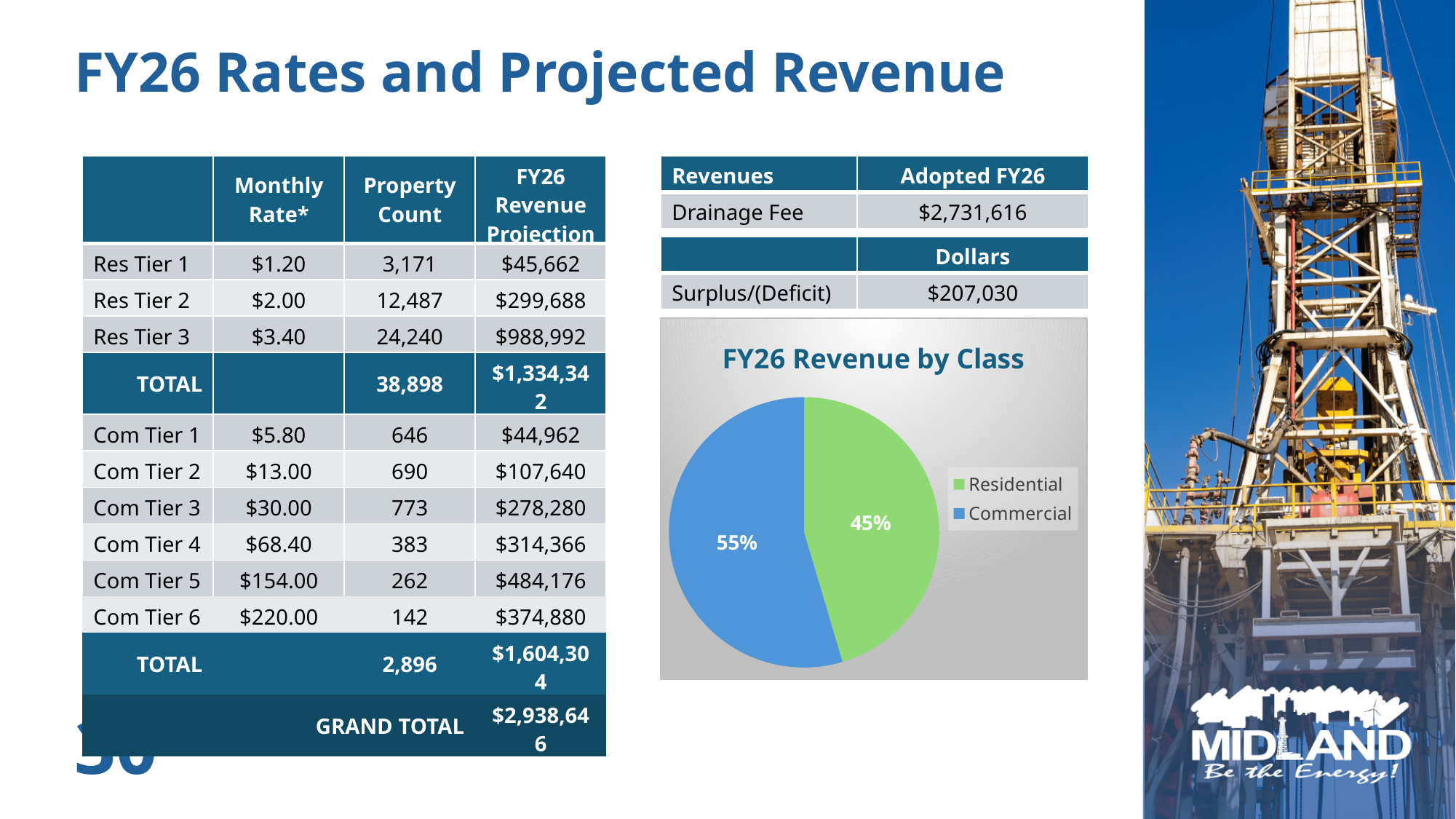
What kind of chart is FY26 Revenue by Class? Pie chart In the FY26 Revenue by Class chart, by how many percentage points does Commercial exceed Residential? 10 percentage points How many entries does the legend of the FY26 Revenue by Class chart list? 2 What share of the FY26 Revenue by Class pie chart is Commercial? 55% In the FY26 Revenue by Class chart, which is larger, Residential or Commercial? Commercial How many slices does the FY26 Revenue by Class pie chart have? 2 Which class has the largest slice in the FY26 Revenue by Class pie chart? Commercial Which class has the smallest slice in the FY26 Revenue by Class pie chart? Residential What share of the FY26 Revenue by Class pie chart is Residential? 45% What is the value shown for the Residential slice in the FY26 Revenue by Class chart? 45% What colour represents Residential in the FY26 Revenue by Class chart? Green What is the value shown for the Commercial slice in the FY26 Revenue by Class chart? 55%